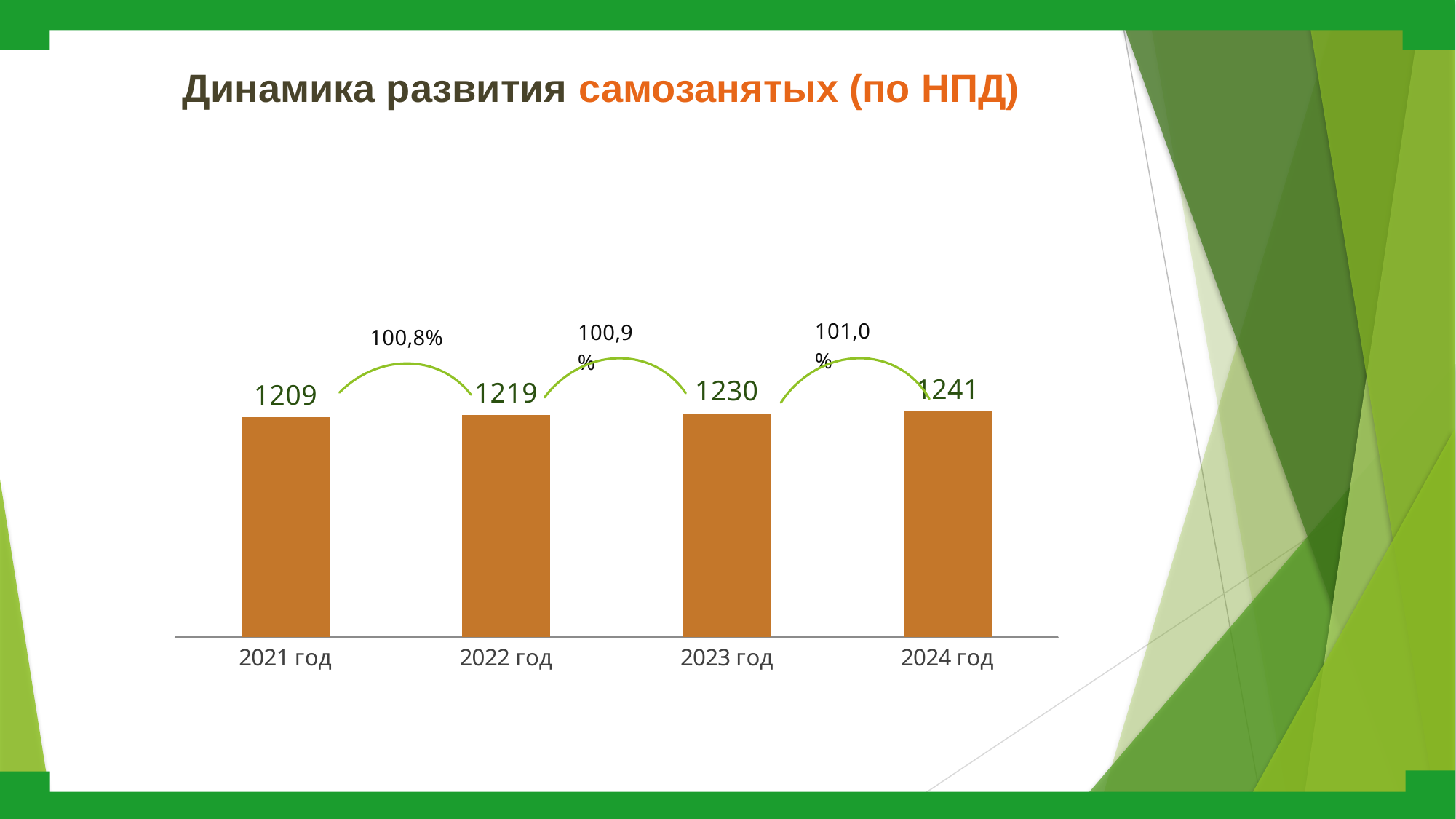
What is the value for 2023 год? 1230 Which year has the lowest value? 2021 год What is the difference between the values for 2024 год and 2021 год? 32 How many years are shown on the x axis? 4 What is the value for 2024 год? 1241 What kind of chart is shown on the slide? bar chart Which is larger, the value for 2022 год or the value for 2024 год? 2024 год What is the value for 2021 год? 1209 What growth percentage is shown between 2021 год and 2022 год? 100,8% Do the values rise or fall from 2021 год to 2024 год? rise Which year has the highest value? 2024 год What is the difference between the values for 2023 год and 2022 год? 11